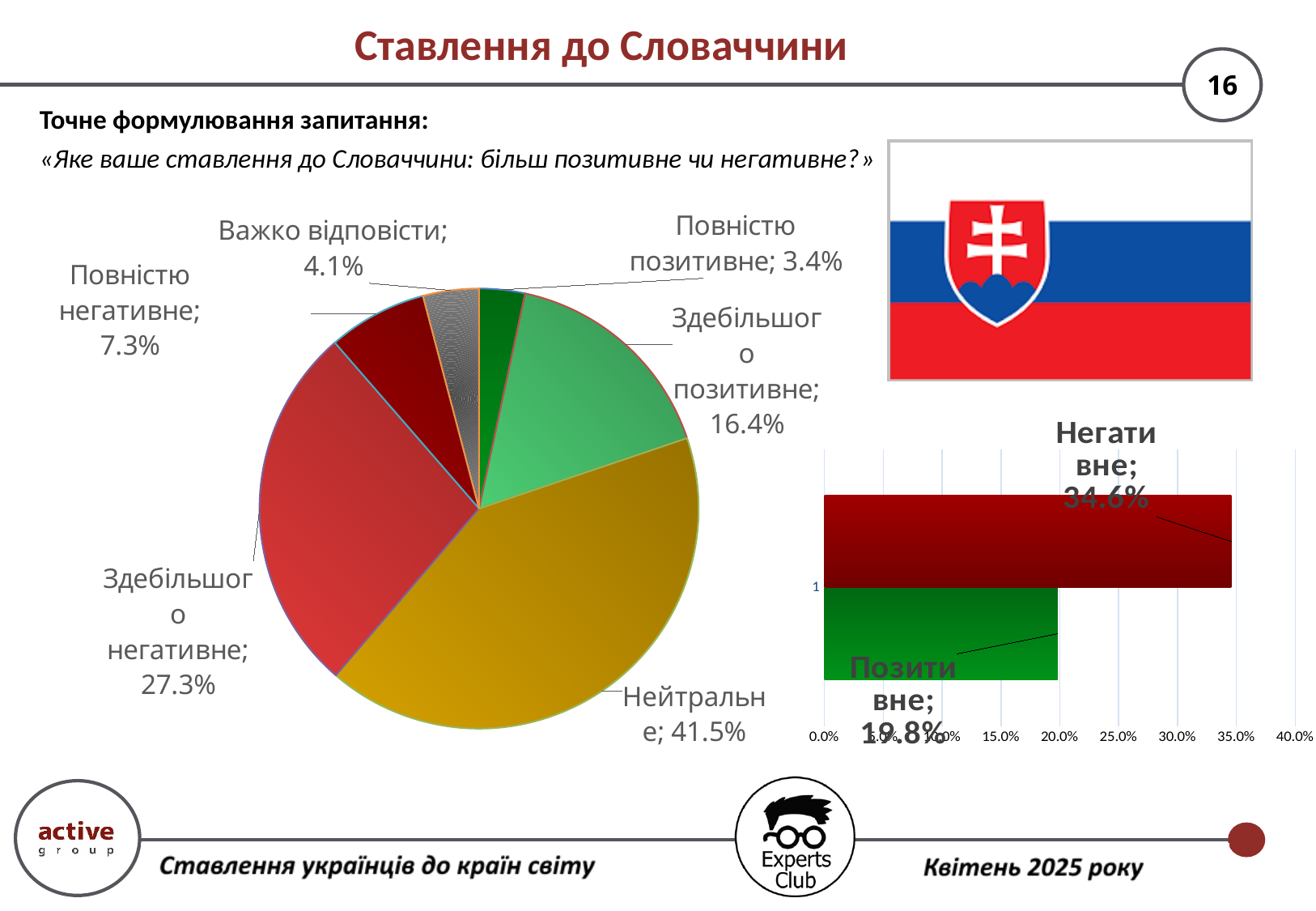
What kind of chart is shown on the right of the slide, below the flag? Bar chart In the pie chart on the left, which is larger: "Важко відповісти" or "Повністю позитивне"? Важко відповісти What kind of chart is shown on the left of the slide? Pie chart In the pie chart on the left, what is the difference between "Здебільшого негативне" and "Здебільшого позитивне"? 10.9% In the pie chart on the left, which category has the smallest share? Повністю позитивне How many slices does the pie chart on the left have? 6 In the bar chart on the right, what is the value for "Негативне"? 34.6% In the pie chart on the left, which category has the largest share? Нейтральне In the pie chart on the left, what is the value for "Здебільшого позитивне"? 16.4% In the pie chart on the left, what is the value for "Нейтральне"? 41.5% In the bar chart on the right, what is the difference between "Негативне" and "Позитивне"? 14.8% In the pie chart on the left, what is the value for "Повністю негативне"? 7.3%